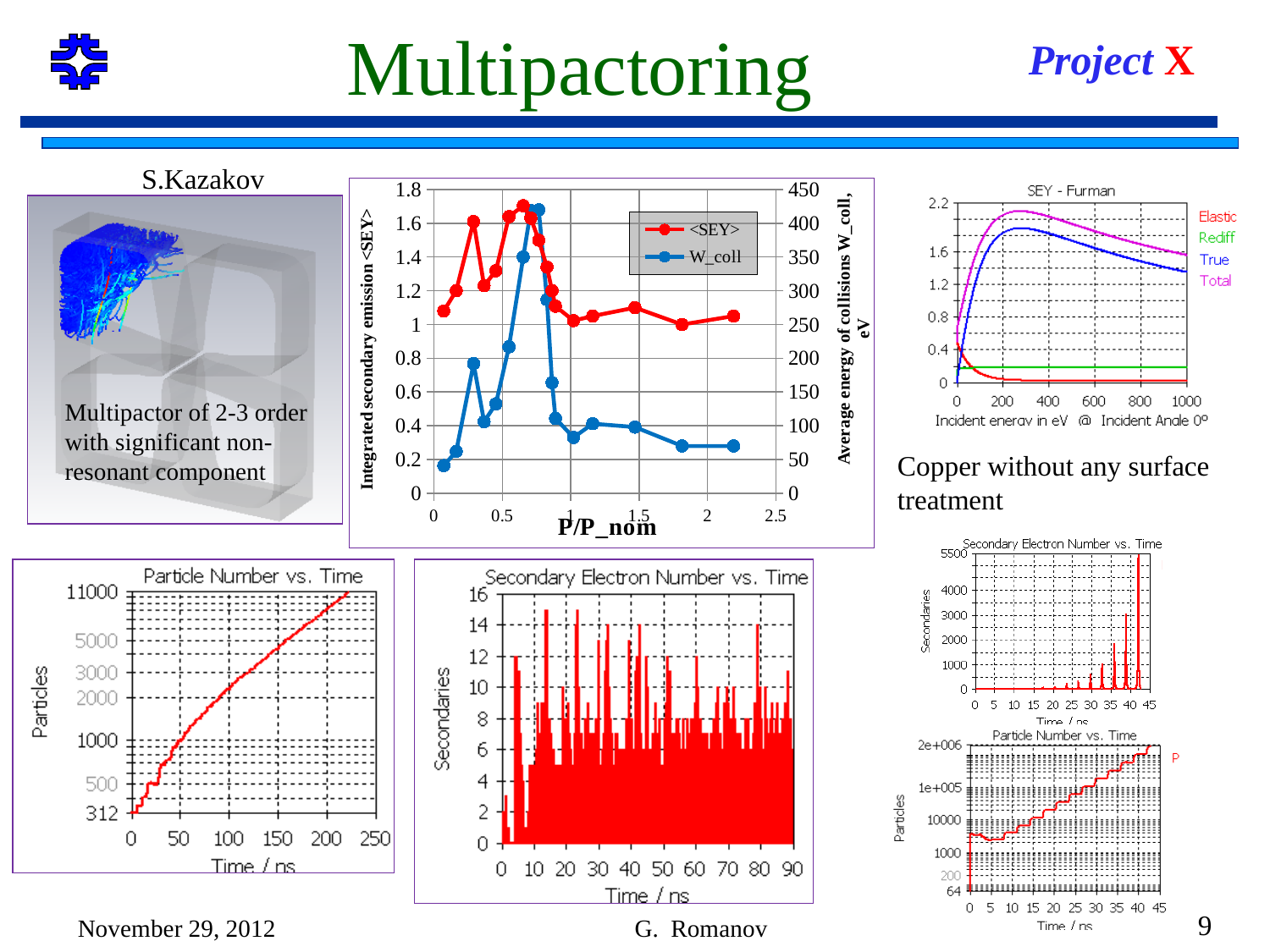
In the top-center chart plotted against P/P_nom, is the peak W_coll value greater or less than 350 eV? greater In the 'SEY - Furman' chart, which series reaches the highest value? Total In the top-center chart plotted against P/P_nom, how many series does the legend list? 2 In the top-center chart plotted against P/P_nom, is the W_coll value at P/P_nom = 2.2 greater or less than 100 eV? less In the top-center chart plotted against P/P_nom, what are the two series named in the legend? <SEY> and W_coll In the top-center chart plotted against P/P_nom, is the <SEY> value at P/P_nom = 2.2 greater or less than 1.2? less What kind of chart is the top-center chart plotted against P/P_nom? line chart In the bottom-right 'Particle Number vs. Time' chart, what is the name of the series shown in the legend? P In the 'SEY - Furman' chart, how many series does the legend list? 4 In the bottom-left 'Particle Number vs. Time' chart, do the particle numbers rise or fall as time increases? rise